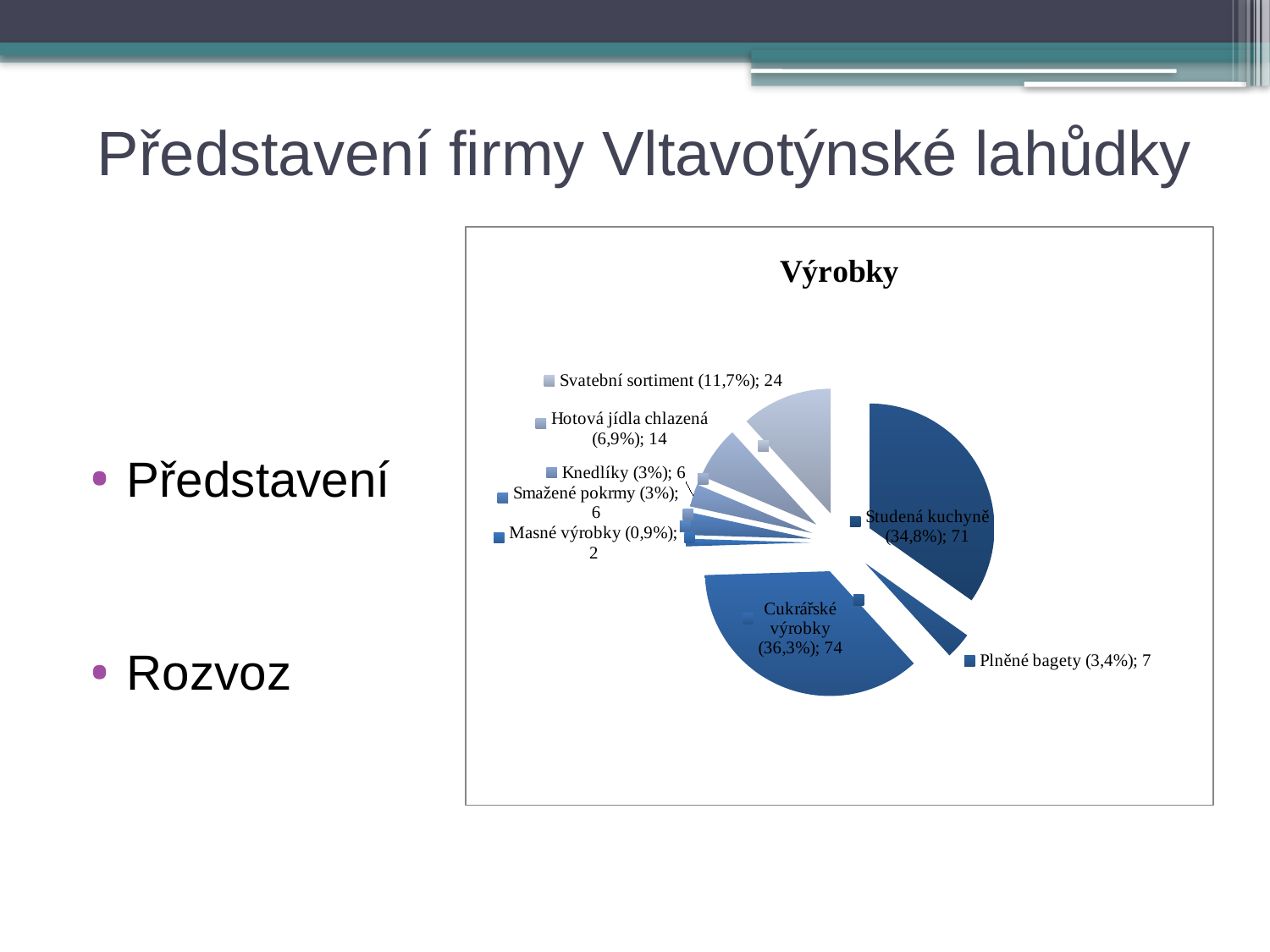
What is the title of the chart? Výrobky What is the value for Hotová jídla chlazená? 14 What share of the pie does Plněné bagety have? 3,4% What is the difference between the values for Cukrářské výrobky and Studená kuchyně? 3 Which is larger, the value for Svatební sortiment or the value for Hotová jídla chlazená? Svatební sortiment What is the value for Studená kuchyně? 71 Which category has the smallest value? Masné výrobky What share of the pie does Cukrářské výrobky have? 36,3% Which category has the largest value? Cukrářské výrobky How many categories does the pie chart show? 8 What type of chart is shown on the slide? pie chart What is the value for Svatební sortiment? 24